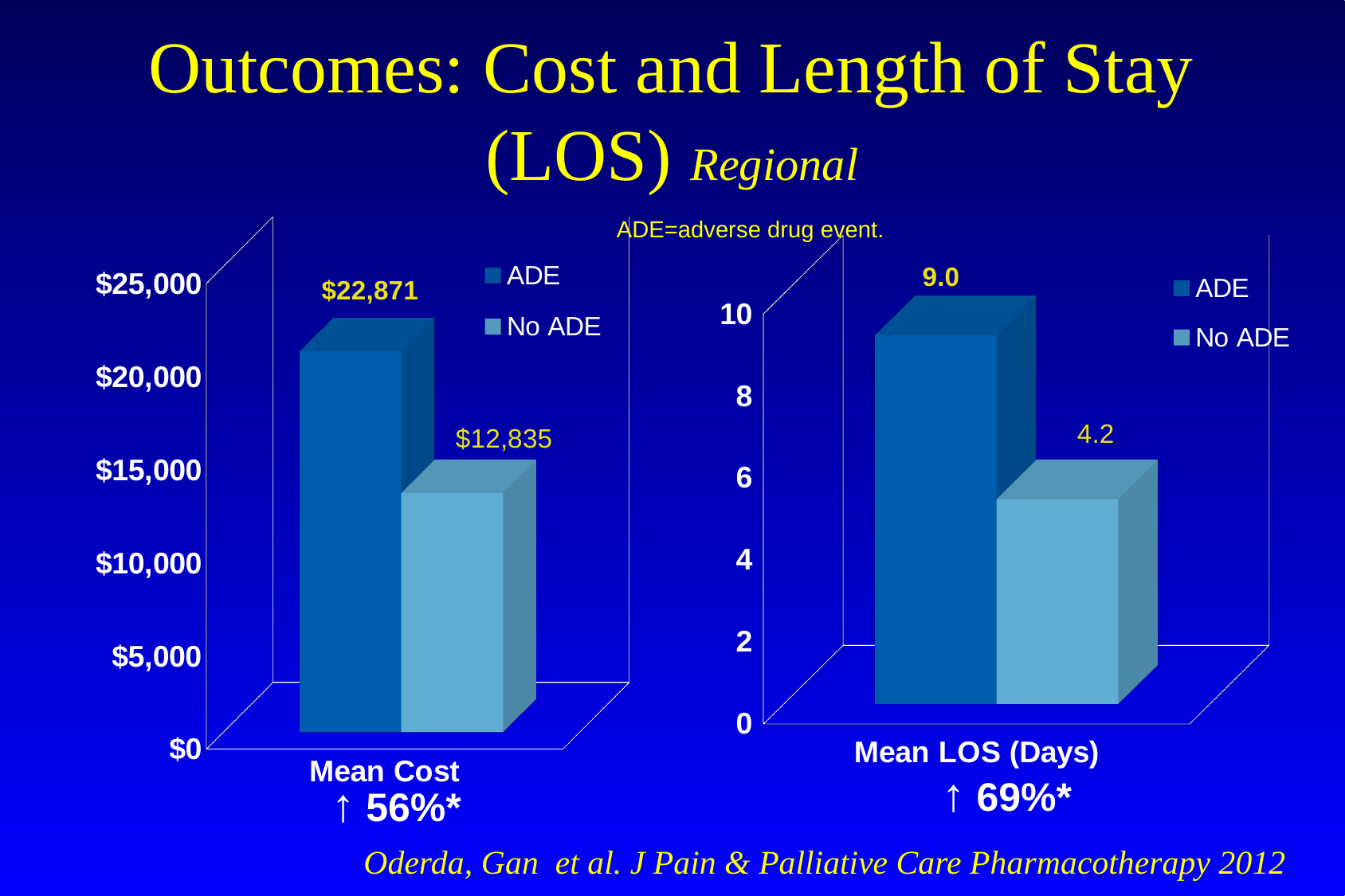
According to the slide, what does ADE stand for? Adverse drug event In the Mean LOS (Days) chart on the right, which group has the lower mean length of stay? No ADE In the Mean Cost chart on the left, what is the mean cost for the No ADE group? $12,835 In the Mean Cost chart on the left, which group has the higher mean cost? ADE In the Mean Cost chart on the left, what is the mean cost for the ADE group? $22,871 In the Mean LOS (Days) chart on the right, is the mean LOS for the No ADE group greater or less than 6? less In the Mean LOS (Days) chart on the right, what is the mean length of stay for the ADE group? 9.0 How many series does the legend of the Mean Cost chart on the left list? 2 In the Mean LOS (Days) chart on the right, what is the mean length of stay for the No ADE group? 4.2 What kind of chart is the Mean LOS (Days) chart on the right? Bar chart In the Mean Cost chart on the left, what is the difference in mean cost between the ADE and No ADE groups? $10,036 In the Mean LOS (Days) chart on the right, what is the difference in mean LOS between the ADE and No ADE groups? 4.8